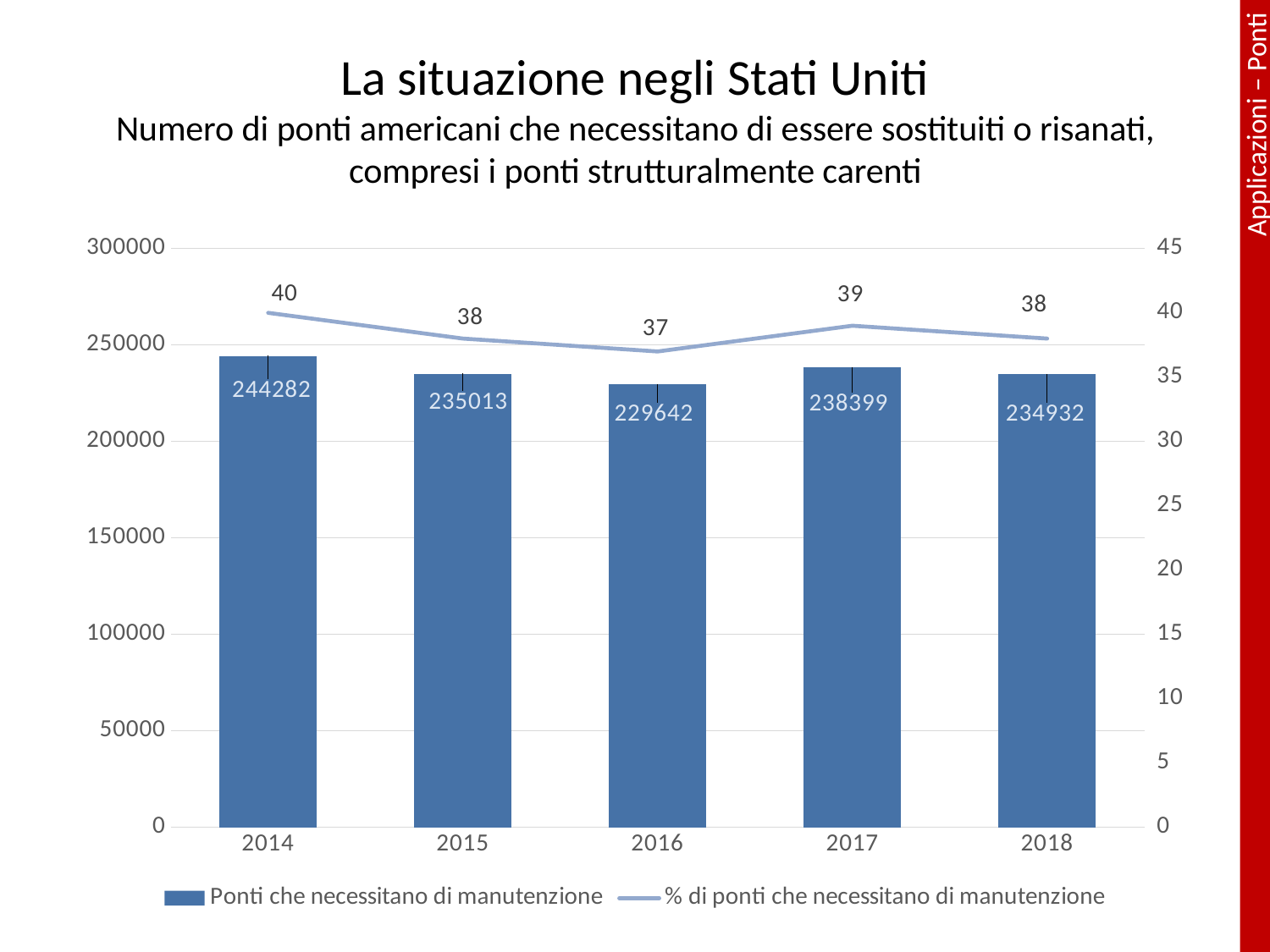
Which year has the lowest number of 'Ponti che necessitano di manutenzione'? 2016 What kind of chart is used for the 'Ponti che necessitano di manutenzione' series? bar chart Which year has the larger 'Ponti che necessitano di manutenzione' value, 2017 or 2018? 2017 Which year has the highest number of 'Ponti che necessitano di manutenzione'? 2014 How many years are shown on the x axis? 5 What is the value of 'Ponti che necessitano di manutenzione' for 2014? 244282 What is the difference between the 'Ponti che necessitano di manutenzione' values for 2014 and 2016? 14640 What is the '% di ponti che necessitano di manutenzione' value for 2016? 37 How many series does the legend list? 2 What is the value of 'Ponti che necessitano di manutenzione' for 2016? 229642 What is the '% di ponti che necessitano di manutenzione' value for 2017? 39 What is the name of the series drawn as a line? % di ponti che necessitano di manutenzione